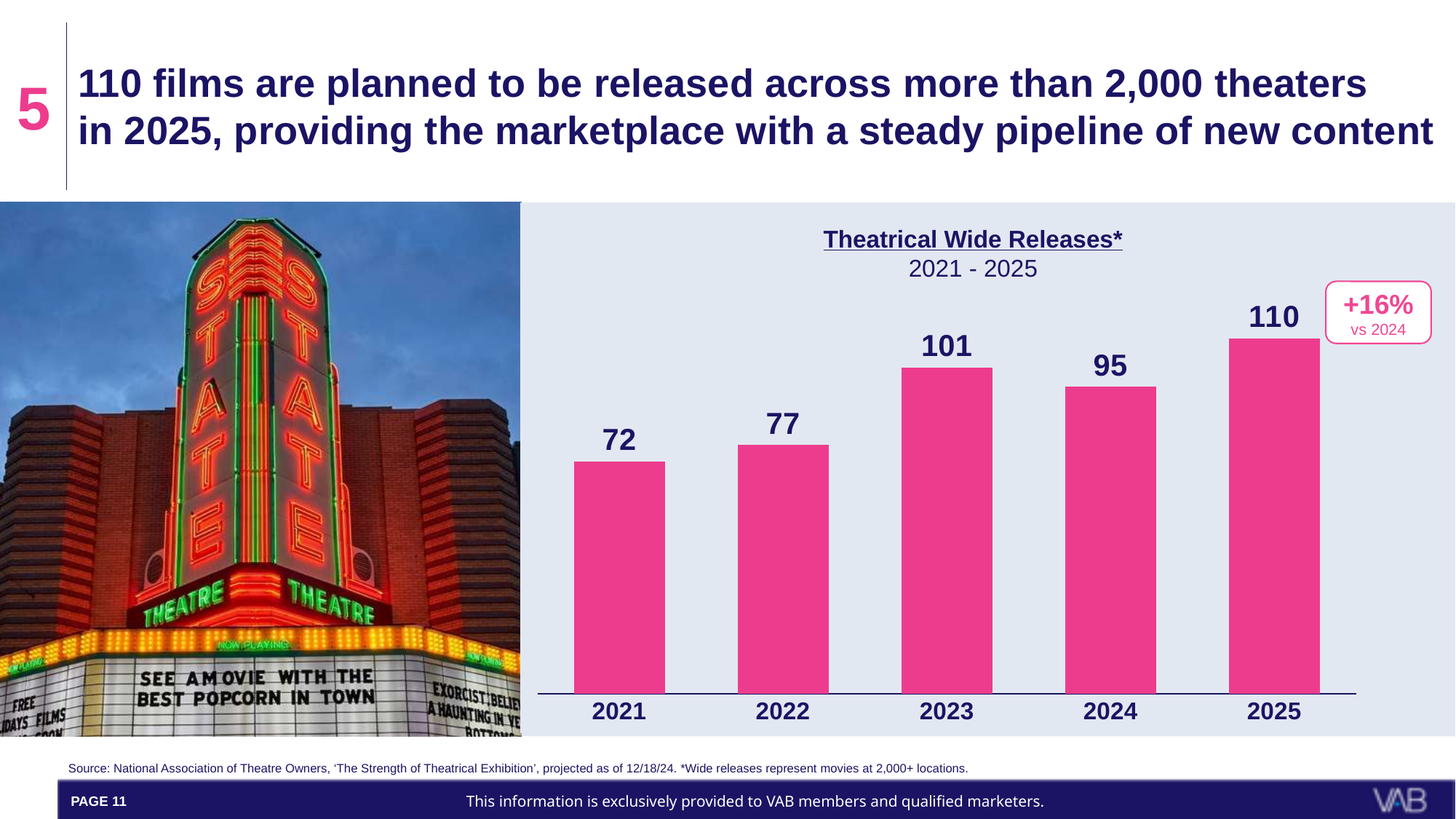
What is the value for 2025 in the Theatrical Wide Releases chart? 110 What kind of chart is used to show Theatrical Wide Releases? Bar chart Which year has the lowest number of theatrical wide releases? 2021 What is the value for 2023 in the Theatrical Wide Releases chart? 101 Which year has a larger value, 2023 or 2024? 2023 Which year has the highest number of theatrical wide releases? 2025 What is the difference between the 2023 and 2022 values in the Theatrical Wide Releases chart? 24 What is the difference between the 2025 and 2024 values in the Theatrical Wide Releases chart? 15 What percentage change versus 2024 is annotated next to the 2025 bar? +16% What is the value for 2021 in the Theatrical Wide Releases chart? 72 What is the title of the chart on the slide? Theatrical Wide Releases* How many years are shown in the Theatrical Wide Releases chart? 5